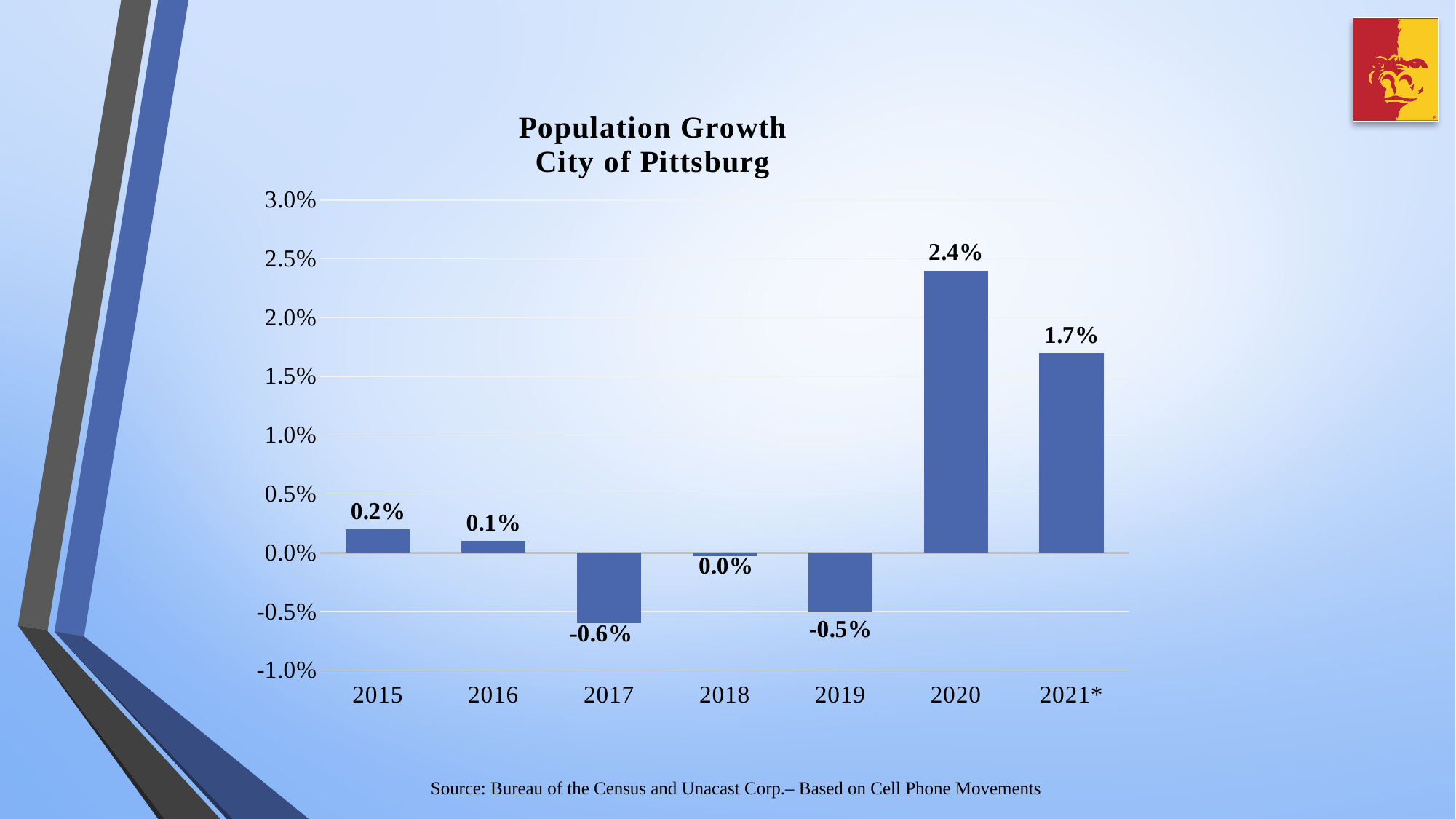
Is the value for 2020 greater or less than 2.0%? greater What is the population growth value for 2021*? 1.7% Which year has the lowest population growth? 2017 How many years are shown on the x axis? 7 What is the population growth value for 2020? 2.4% What is the title of the chart? Population Growth City of Pittsburg What is the difference between the population growth in 2020 and 2021*? 0.7% What is the population growth value for 2017? -0.6% Which year has the larger population growth, 2015 or 2016? 2015 Which year has the highest population growth? 2020 What kind of chart is shown on the slide? Bar chart Does the population growth rise or fall from 2019 to 2020? Rise